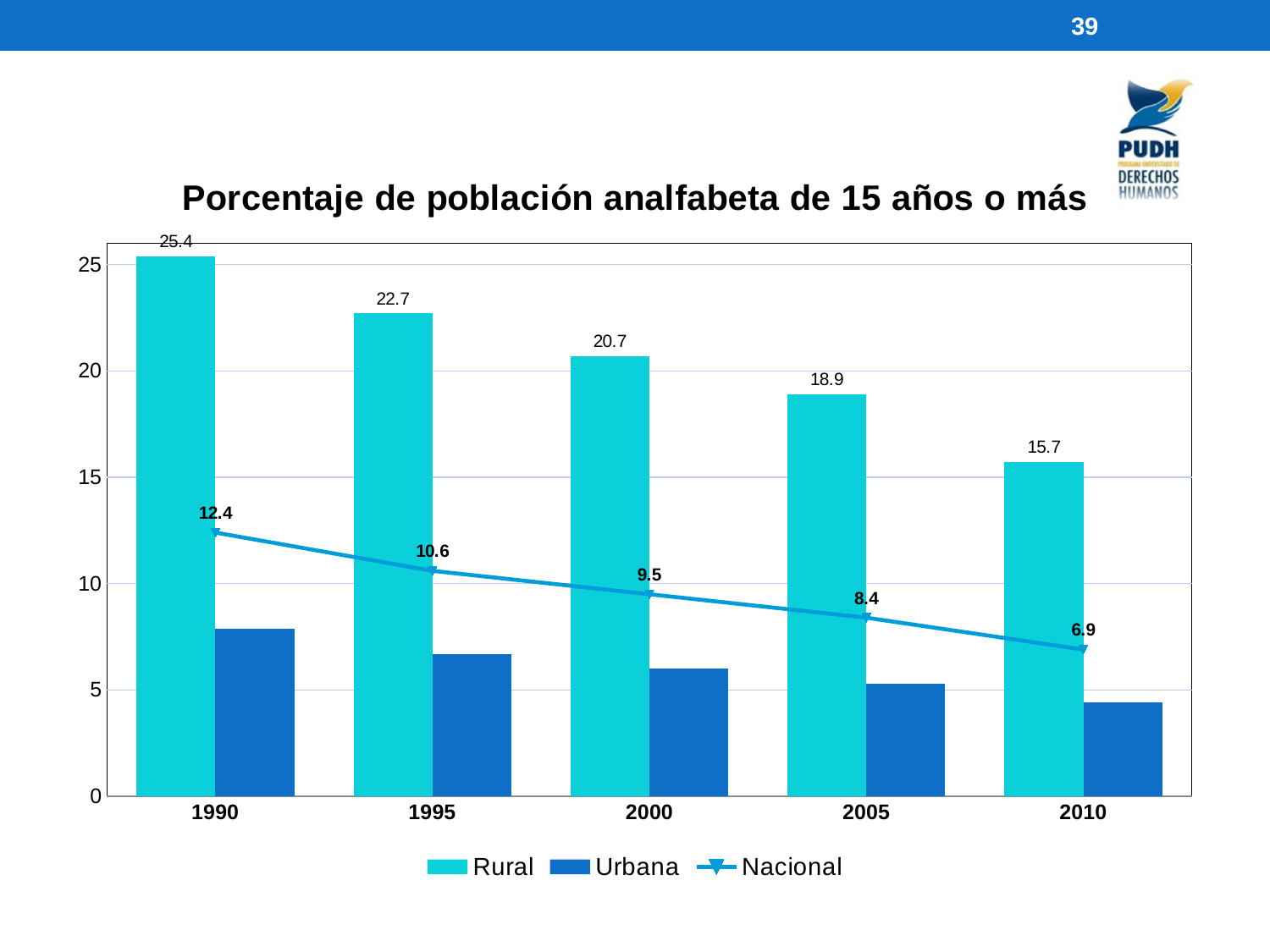
What is the difference between the Rural values for 1990 and 2010? 9.7 Is the Urbana value for 1990 greater or less than 5? greater How many years are shown on the x axis? 5 Which year has the highest Rural value? 1990 What is the Rural value for 1990? 25.4 Is the Urbana value for 2010 greater or less than 5? less What is the Nacional value for 2005? 8.4 How many series does the legend list? 3 What is the Rural value for 2010? 15.7 What is the difference between the Nacional values for 1995 and 2000? 1.1 Which year has the lowest Nacional value? 2010 Which is larger, the Rural value for 2000 or the Rural value for 2005? Rural value for 2000